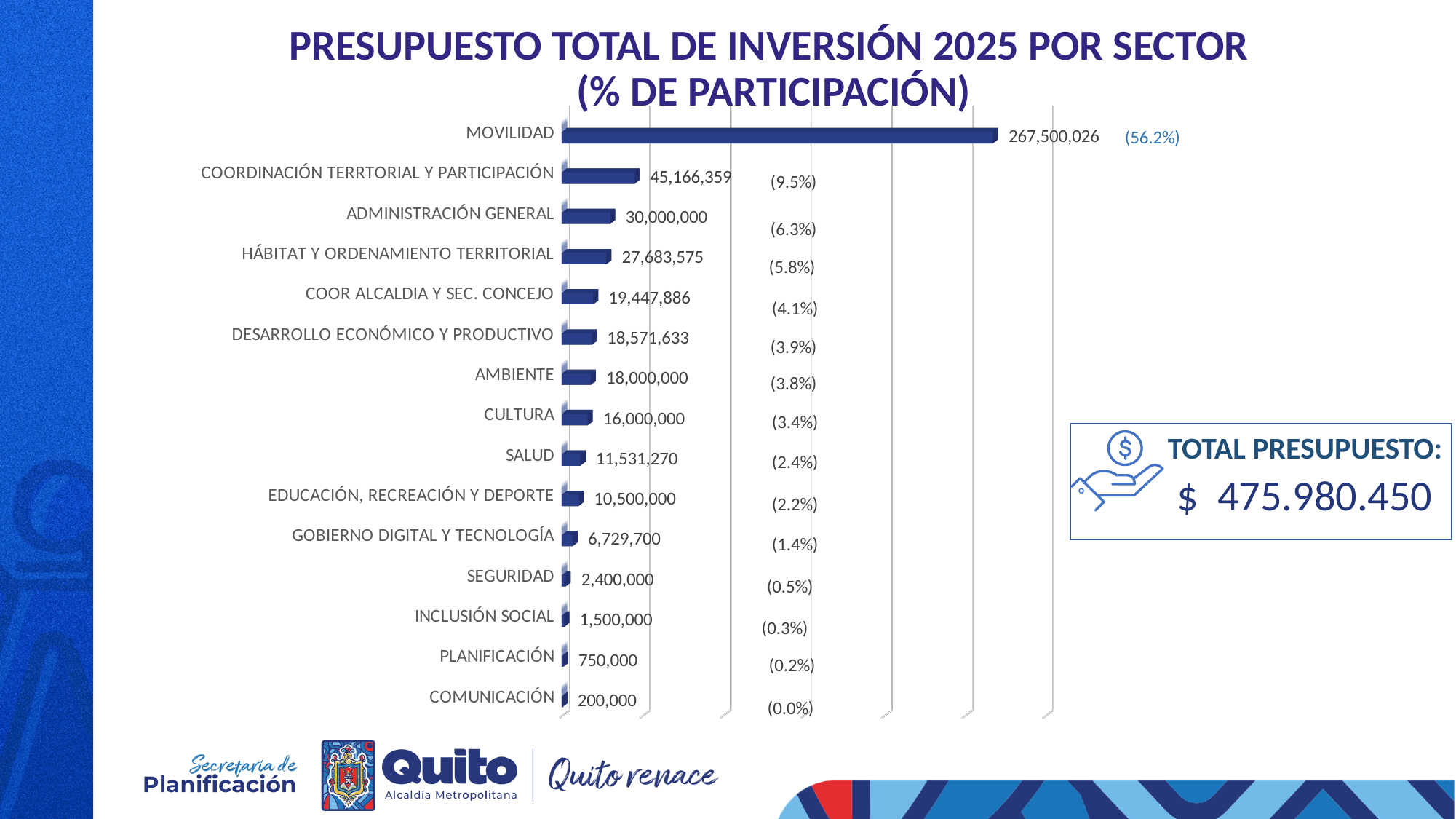
Which is larger, the value for SEGURIDAD or the value for INCLUSIÓN SOCIAL? SEGURIDAD What is the value for GOBIERNO DIGITAL Y TECNOLOGÍA? 6,729,700 Which sector has the lowest value? COMUNICACIÓN What total budget (TOTAL PRESUPUESTO) is shown on the slide? $ 475.980.450 What is the difference between the values for AMBIENTE and SALUD? 6,468,730 What percentage of participation is shown for SALUD? 2.4% What kind of chart is shown on the slide? Bar chart What is the value for HÁBITAT Y ORDENAMIENTO TERRITORIAL? 27,683,575 How many sectors are shown in the chart? 15 What is the difference between the values for ADMINISTRACIÓN GENERAL and CULTURA? 14,000,000 What is the value for MOVILIDAD? 267,500,026 Which sector has the highest value? MOVILIDAD